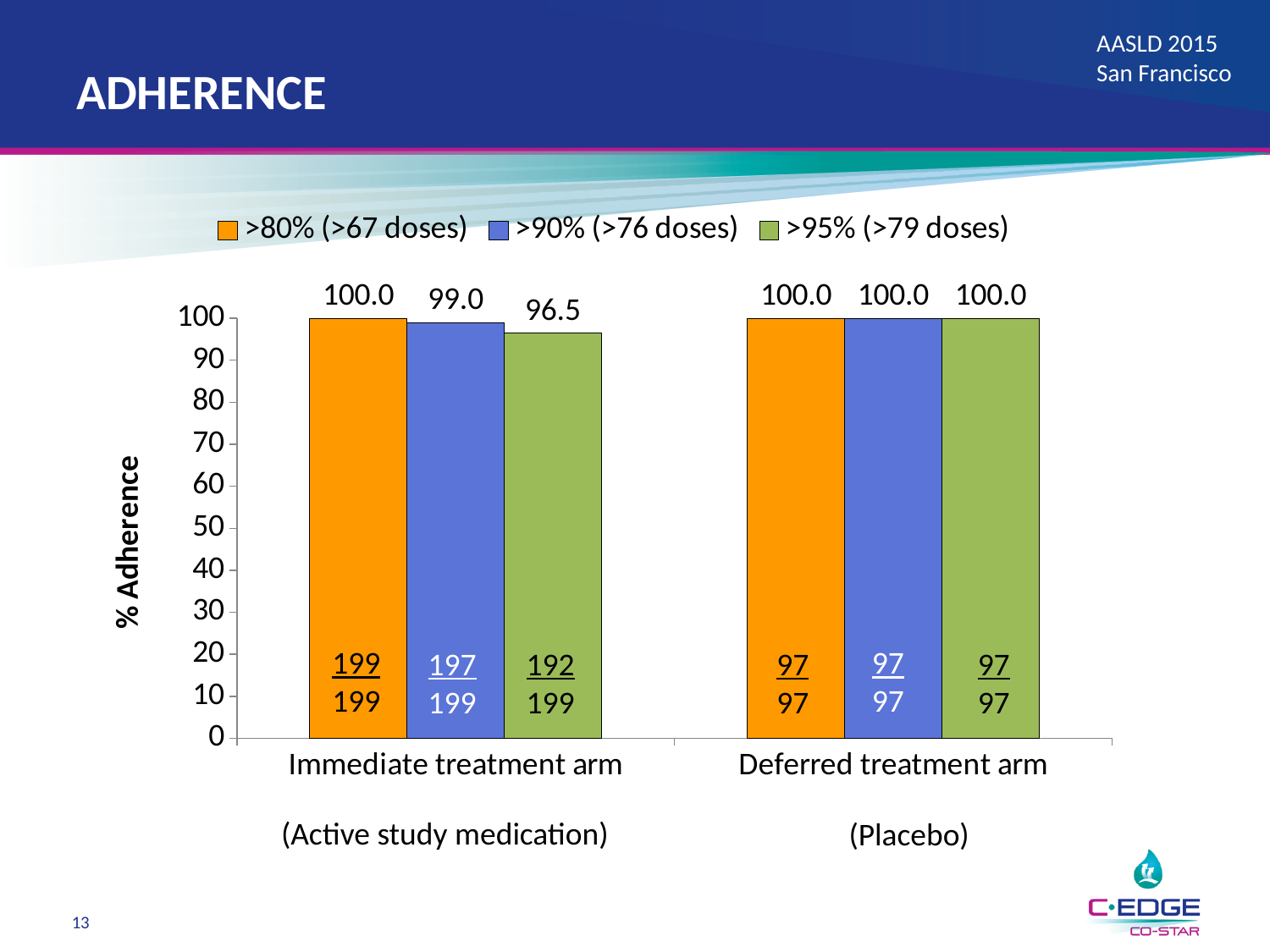
Which colour represents the >80% (>67 doses) series? Orange What is the difference in % Adherence for >95% (>79 doses) between the Deferred treatment arm and the Immediate treatment arm? 3.5 Which adherence threshold has the lowest % Adherence in the Immediate treatment arm? >95% (>79 doses) What is the % Adherence for >90% (>76 doses) in the Immediate treatment arm? 99.0 What is the label of the y axis? % Adherence What is the % Adherence for >80% (>67 doses) in the Deferred treatment arm? 100.0 How many treatment arm categories are shown on the x axis? 2 What is the difference in % Adherence between >80% (>67 doses) and >95% (>79 doses) in the Immediate treatment arm? 3.5 How many series does the legend list? 3 What kind of chart is shown on the slide? Bar chart What is the % Adherence for >95% (>79 doses) in the Immediate treatment arm? 96.5 Which is larger: the % Adherence for >90% (>76 doses) in the Immediate treatment arm or in the Deferred treatment arm? Deferred treatment arm